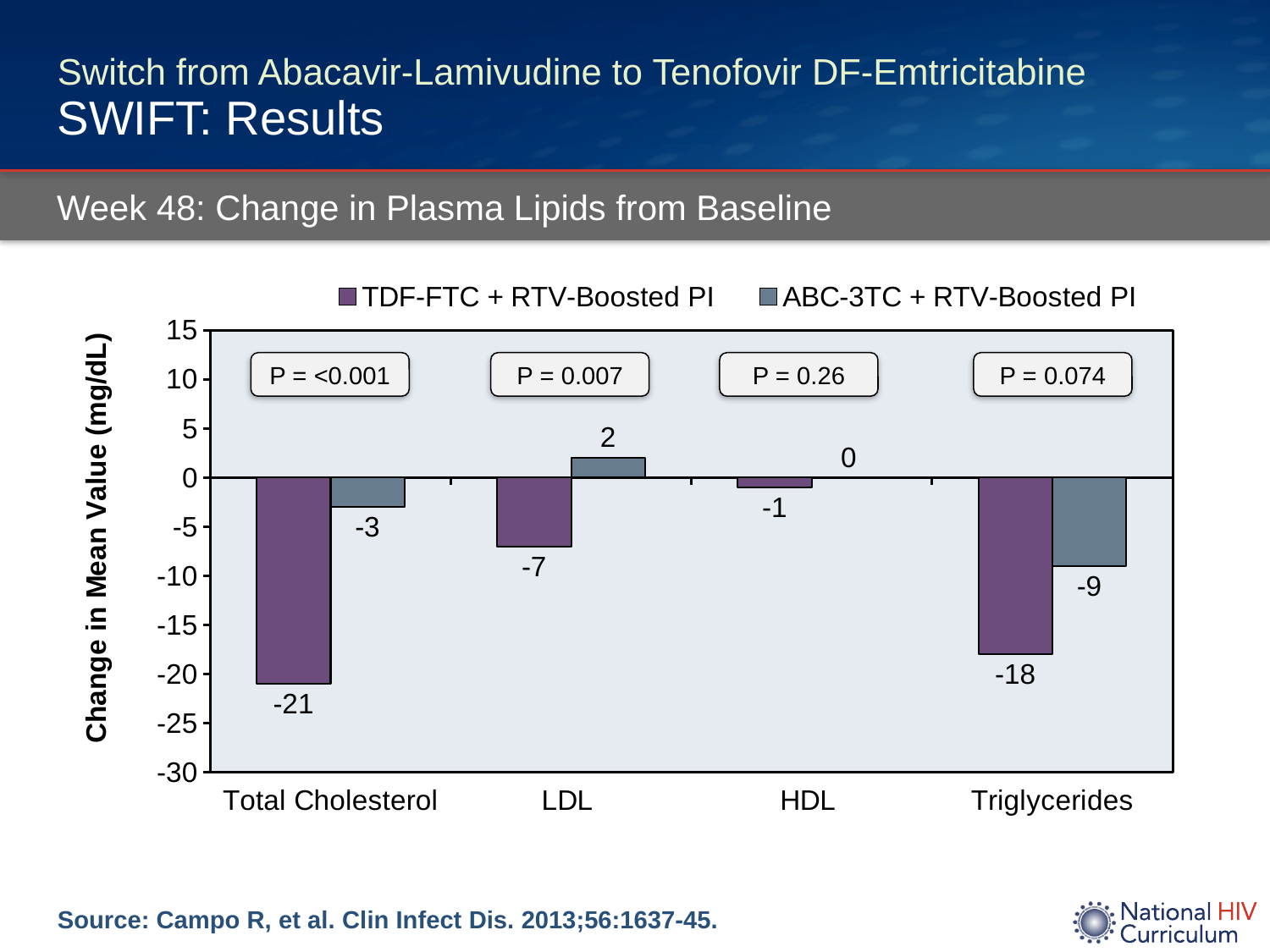
What is the difference between the TDF-FTC + RTV-Boosted PI and ABC-3TC + RTV-Boosted PI values for Total Cholesterol? 18 How many series does the legend list? 2 Which lipid category shows the lowest (most negative) value for the TDF-FTC + RTV-Boosted PI group? Total Cholesterol For LDL, which group has the larger change in mean value? TDF-FTC + RTV-Boosted PI What is the change in mean value for Total Cholesterol in the TDF-FTC + RTV-Boosted PI group? -21 What is the change in mean value for HDL in the TDF-FTC + RTV-Boosted PI group? -1 What kind of chart is shown on the slide? Bar chart How many lipid categories are shown on the x axis? 4 What is the change in mean value for Triglycerides in the ABC-3TC + RTV-Boosted PI group? -9 What is the change in mean value for LDL in the ABC-3TC + RTV-Boosted PI group? 2 What is the difference between the TDF-FTC + RTV-Boosted PI and ABC-3TC + RTV-Boosted PI values for Triglycerides? 9 Which lipid category shows the highest value for the ABC-3TC + RTV-Boosted PI group? LDL